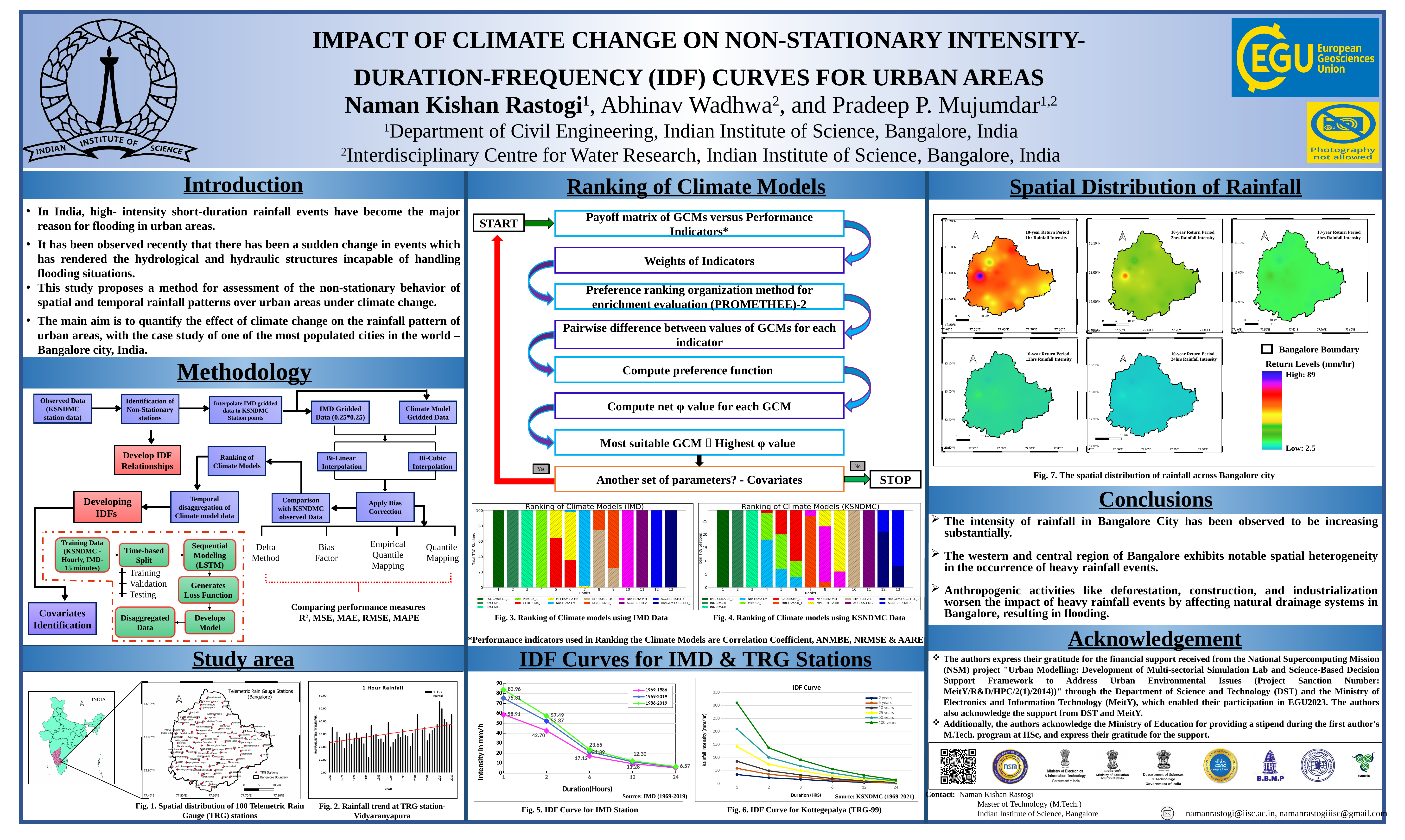
In Fig. 5 (IDF Curve for IMD Station), what is the lowest intensity value labelled at a duration of 1 hour? 58.91 In Fig. 5 (IDF Curve for IMD Station), what kind of chart is shown? line chart In Fig. 5 (IDF Curve for IMD Station), what is the difference between the highest (83.96) and lowest (58.91) labelled values at 1 hour? 25.05 In Fig. 3 (Ranking of Climate Models (IMD)), how many ranks are shown on the x axis? 13 In Fig. 6 (IDF Curve for Kottegepalya TRG-99), how many return-period series does the legend list? 6 In Fig. 5 (IDF Curve for IMD Station), do the intensity values rise or fall as duration increases? fall What is the title of the chart in Fig. 2 (Rainfall trend at TRG station - Vidyaranyapura)? 1 Hour Rainfall In Fig. 5 (IDF Curve for IMD Station), how many series does the legend list? 3 In Fig. 5 (IDF Curve for IMD Station), what is the highest intensity value labelled at a duration of 1 hour? 83.96 In Fig. 5 (IDF Curve for IMD Station), what intensity value is labelled at a duration of 24 hours? 6.57 In Fig. 6 (IDF Curve for Kottegepalya TRG-99), which return-period series has the highest rainfall intensity at 1 hour? 100 years In Fig. 6 (IDF Curve for Kottegepalya TRG-99), is the 100-year value at 1 hour greater or less than 250? greater